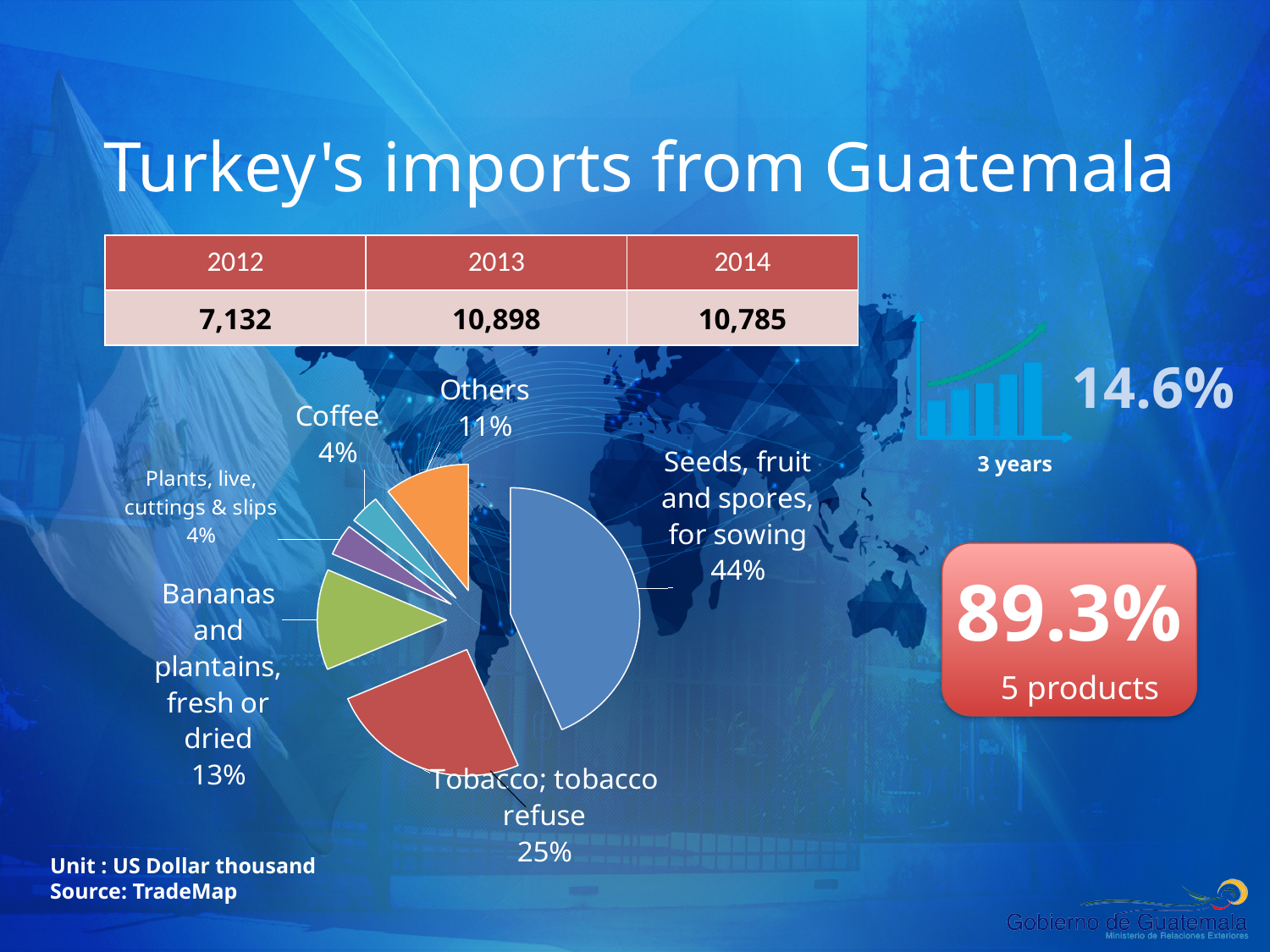
What share of the pie chart is labelled 'Others'? 11% What kind of chart is shown on the slide? pie chart What percentage is shown for 'Bananas and plantains, fresh or dried'? 13% What is the title of the slide containing the pie chart? Turkey's imports from Guatemala Which is larger in the pie chart: 'Tobacco; tobacco refuse' or 'Bananas and plantains, fresh or dried'? Tobacco; tobacco refuse What is the value shown for Coffee in the pie chart? 4% How many slices does the pie chart have? 6 What share of the pie chart does 'Seeds, fruit and spores, for sowing' represent? 44% Which category has the largest slice in the pie chart? Seeds, fruit and spores, for sowing What is the difference in percentage points between 'Seeds, fruit and spores, for sowing' and 'Tobacco; tobacco refuse'? 19 percentage points What is the value shown for 'Tobacco; tobacco refuse' in the pie chart? 25% What percentage is shown for 'Plants, live, cuttings & slips'? 4%